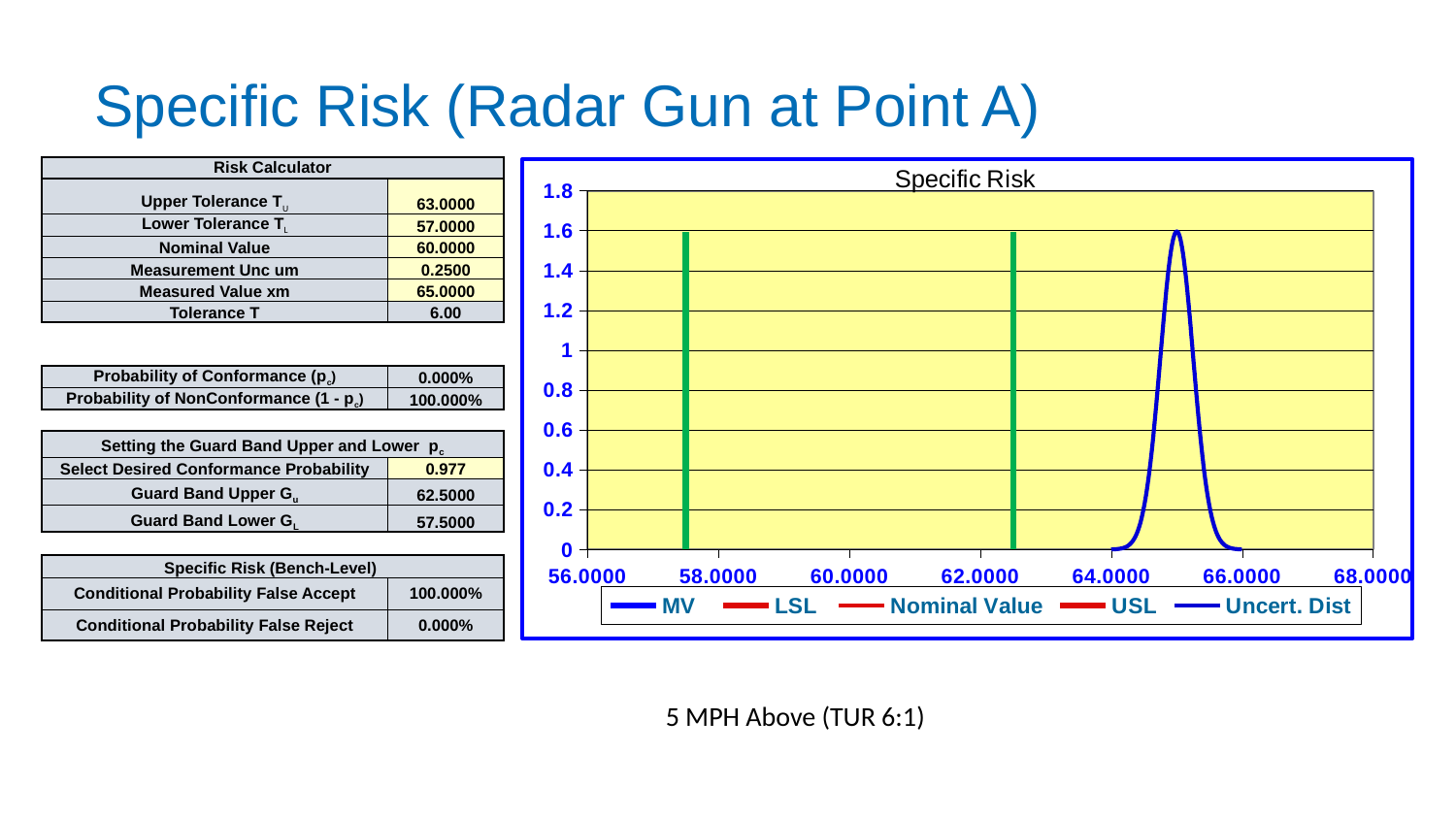
What is the highest tick label shown on the y axis of the chart? 1.8 What is the title of the chart? Specific Risk Is the x-axis position of the peak of the Uncert. Dist curve greater or less than 66.0000? less Is the peak value of the Uncert. Dist curve greater or less than 1.4? greater Does the Uncert. Dist curve rise or fall as the x axis moves from 65.0000 toward 66.0000? fall What kind of chart is shown on the slide? line chart How many tick labels are shown on the x axis of the chart? 7 Is the peak value of the Uncert. Dist curve greater or less than 1.8? less How many series does the chart's legend list? 5 What is the lowest tick label shown on the x axis of the chart? 56.0000 What are the legend entries of the chart, in order? MV, LSL, Nominal Value, USL, Uncert. Dist